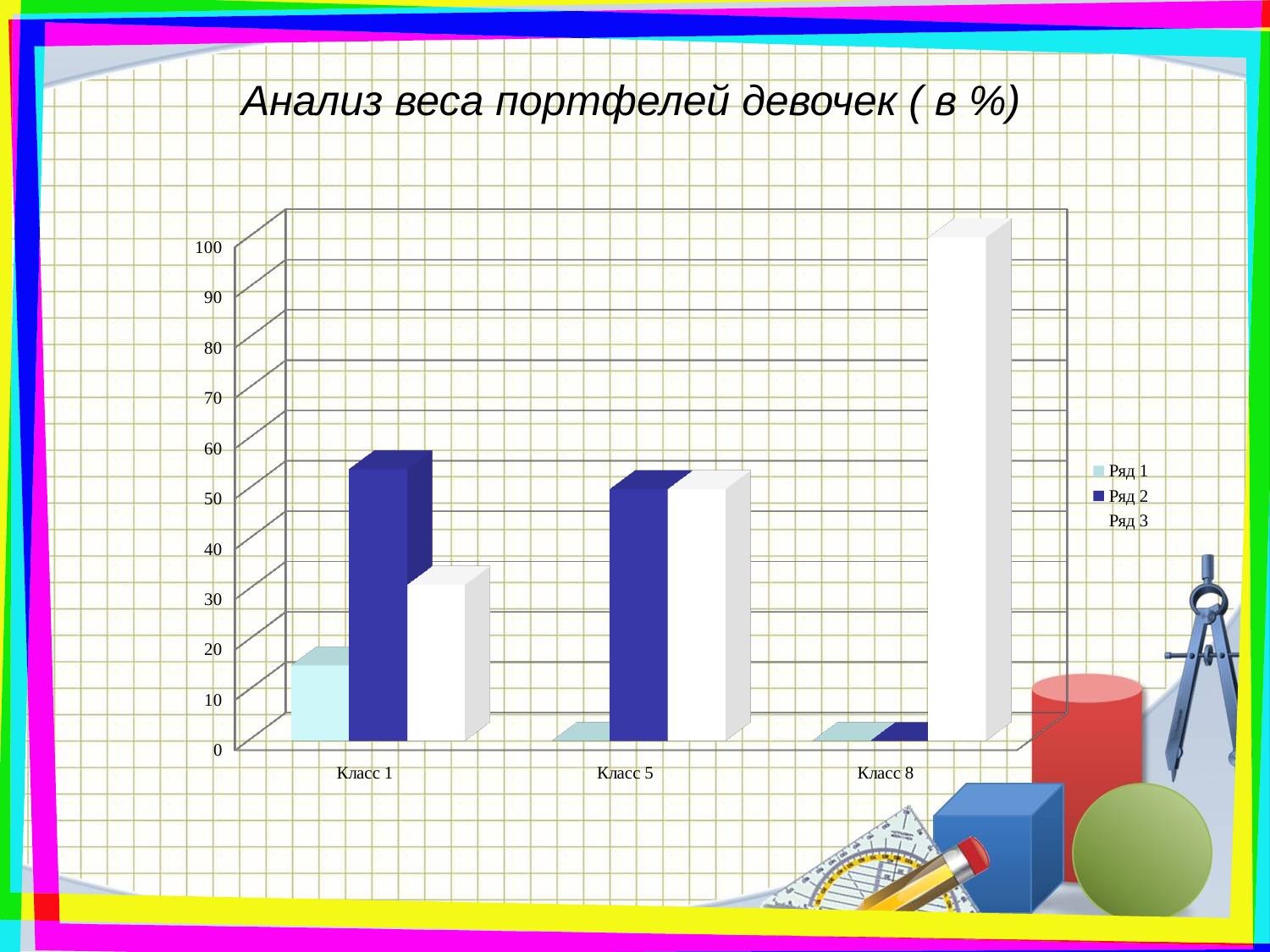
Is the value for Ряд 3 in Класс 8 greater or less than 90? greater Is the value for Ряд 3 in Класс 1 greater or less than 40? less What kind of chart is shown on the slide? bar chart What is the title of the chart? Анализ веса портфелей девочек ( в %) How many series does the legend list? 3 Is the value for Ряд 2 in Класс 1 greater or less than 40? greater Which category has the highest value for Ряд 3? Класс 8 Which category has the highest value for Ряд 1? Класс 1 How many categories are shown on the x axis? 3 Which category has the lowest value for Ряд 2? Класс 8 Do the values for Ряд 3 rise or fall from Класс 1 to Класс 8? rise For Класс 1, which is larger: Ряд 2 or Ряд 3? Ряд 2